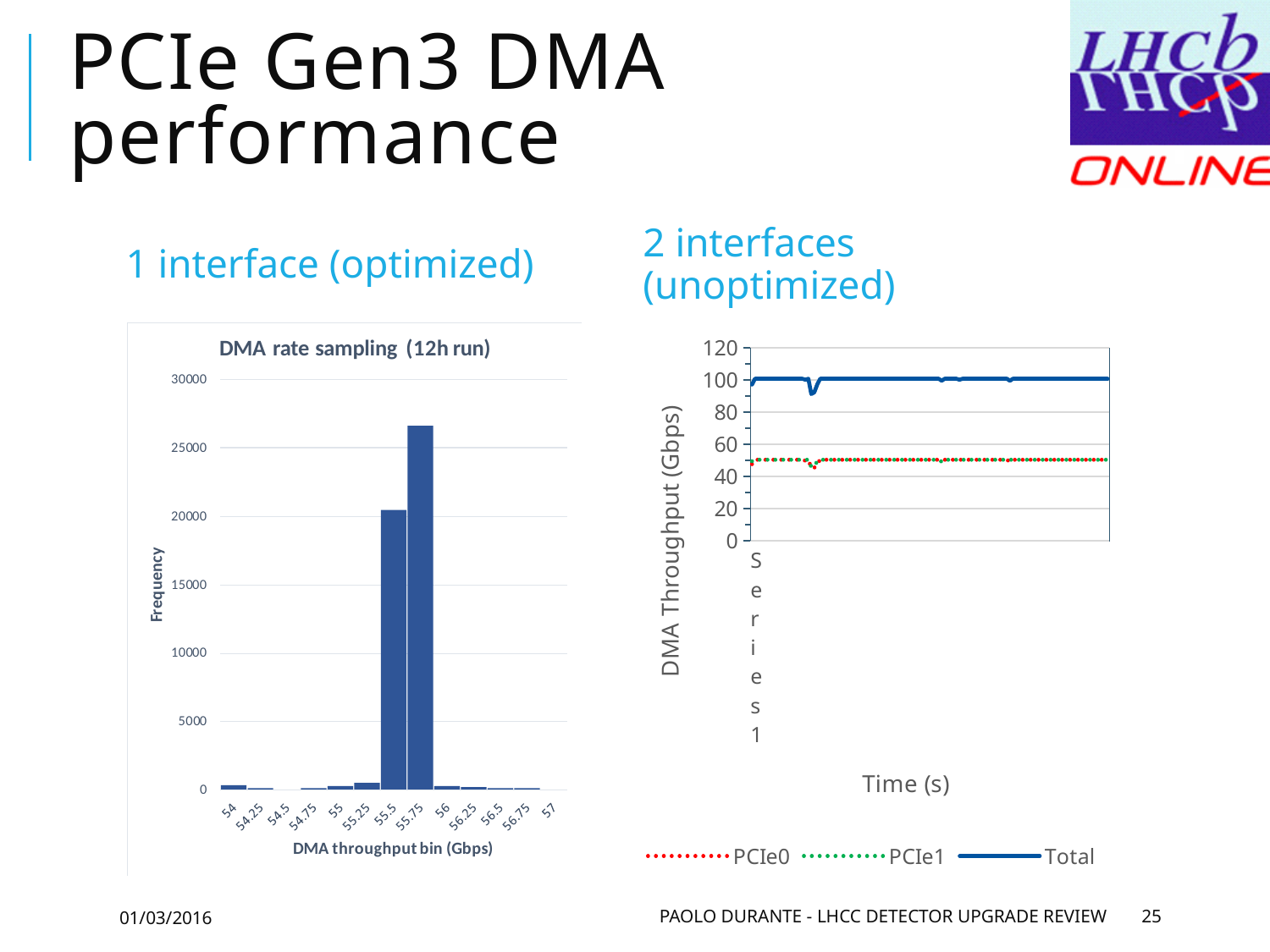
In the left chart 'DMA rate sampling (12h run)', how many throughput bins are shown on the x axis? 13 What type of chart is the right chart with the 'Time (s)' x-axis? line chart In the left chart 'DMA rate sampling (12h run)', is the frequency for the 55.5 bin greater or less than 15000? greater In the left chart 'DMA rate sampling (12h run)', which bin has the higher frequency, 55.5 or 55.75? 55.75 In the right chart, is the Total throughput greater or less than 80 Gbps for most of the run? greater In the right chart, which series has the higher throughput, Total or PCIe1? Total What type of chart is the left chart titled 'DMA rate sampling (12h run)'? bar chart In the right chart, is the PCIe0 throughput greater or less than 60 Gbps? less In the right chart, how many series does the legend list? 3 In the left chart 'DMA rate sampling (12h run)', which DMA throughput bin has the highest frequency? 55.75